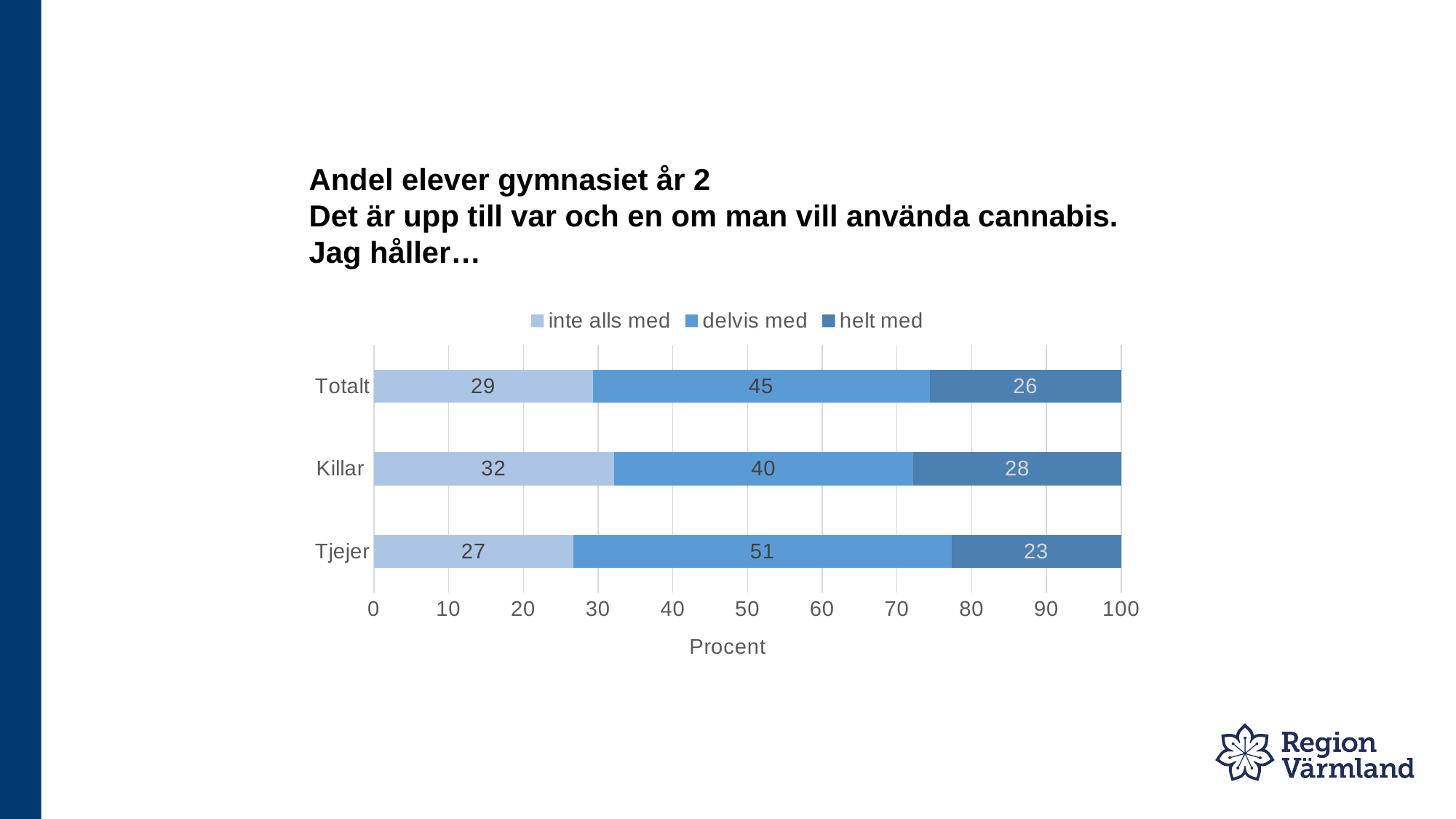
What kind of chart is shown on the slide? Stacked bar chart What is the value for "inte alls med" for Killar? 32 Which category has the highest value for "delvis med"? Tjejer What is the total of the stacked bar for Killar? 100 Which category has the lowest value for "helt med"? Tjejer What is the label of the x axis? Procent How many categories are shown on the y axis? 3 How many series does the legend list? 3 What is the difference between the "inte alls med" values for Killar and Tjejer? 5 What is the value for "helt med" for Totalt? 26 Which is larger: "helt med" for Killar or "helt med" for Totalt? Killar What is the value for "delvis med" for Tjejer? 51